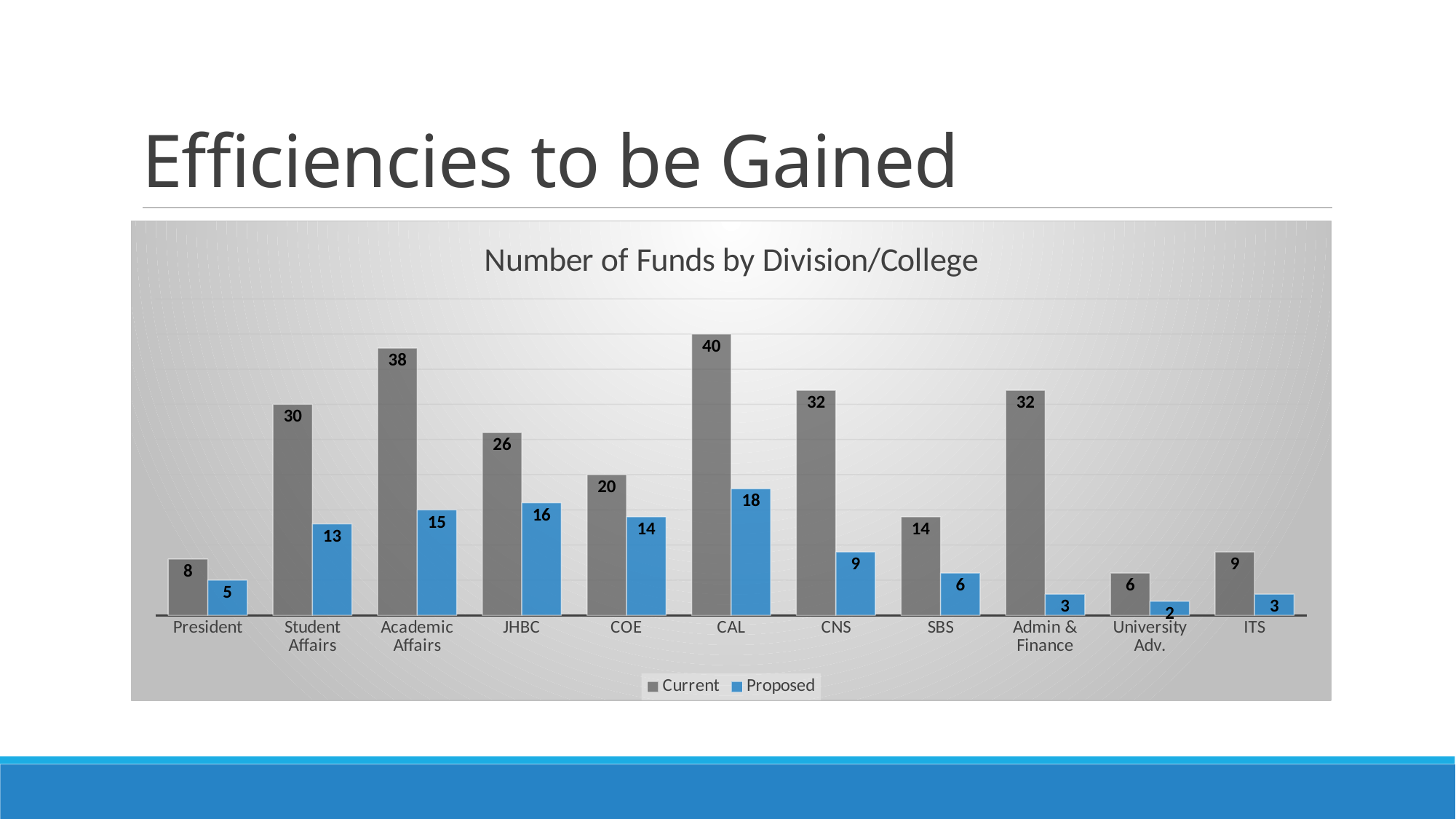
How many divisions/colleges are shown on the x axis? 11 What is the title of the chart? Number of Funds by Division/College Which division/college has the lowest Proposed number of funds? University Adv. Which is larger: the Current number of funds for JHBC or for COE? JHBC What is the Current number of funds for CAL? 40 What is the difference between the Current and Proposed number of funds for Academic Affairs? 23 How many series does the legend list? 2 What is the Proposed number of funds for Student Affairs? 13 What kind of chart is shown on the slide? Bar chart Which division/college has the highest Current number of funds? CAL What is the Proposed number of funds for University Adv.? 2 Which colour represents the Proposed series? Blue